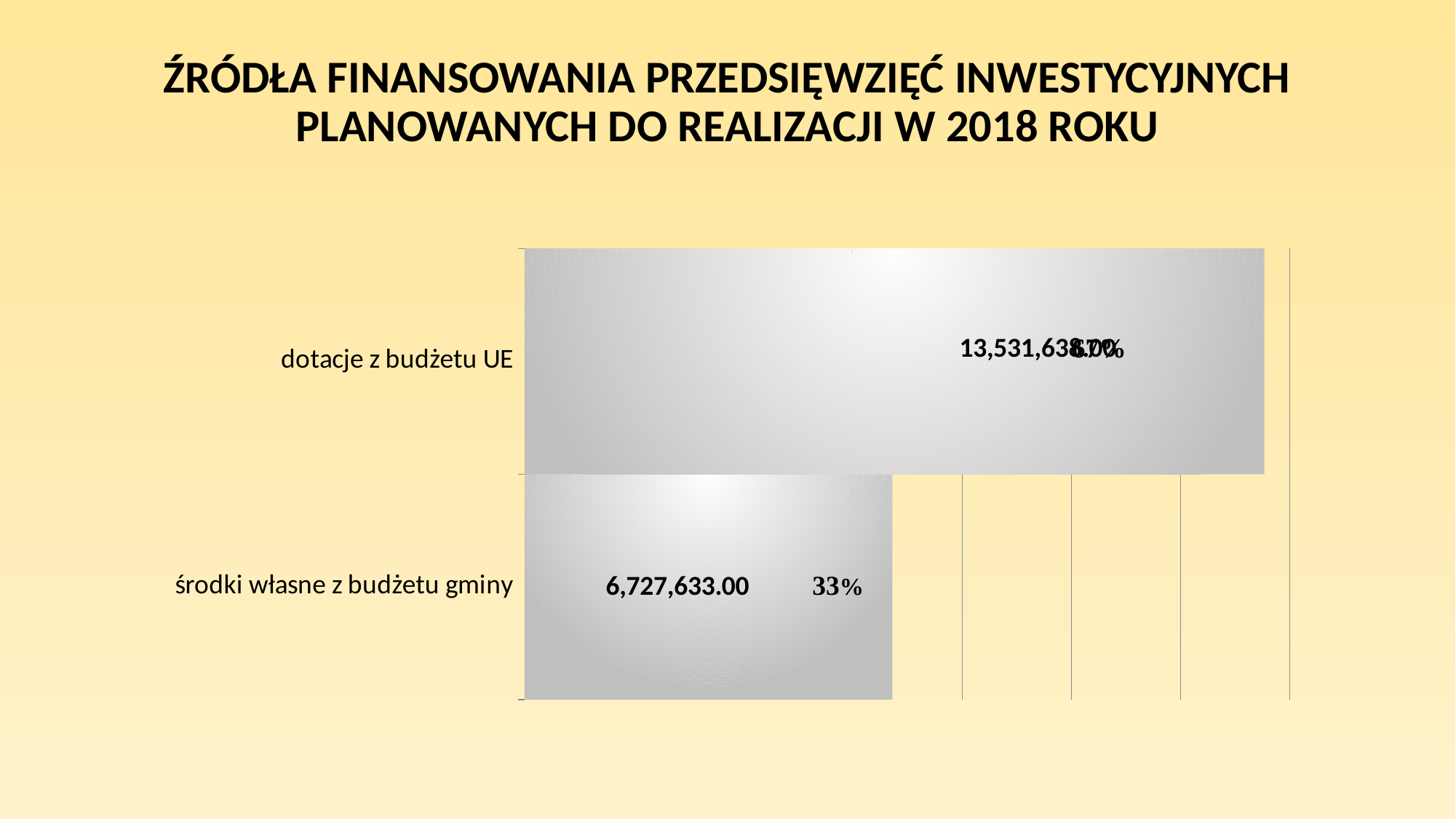
Which category has the highest value in the chart? dotacje z budżetu UE What is the title of the slide containing the chart? ŹRÓDŁA FINANSOWANIA PRZEDSIĘWZIĘĆ INWESTYCYJNYCH PLANOWANYCH DO REALIZACJI W 2018 ROKU What kind of chart is shown on the slide? bar chart Are the bars in the chart horizontal or vertical? horizontal How many categories are plotted in the chart? 2 What percentage share is shown for środki własne z budżetu gminy? 33% Which is larger: the value for dotacje z budżetu UE or the value for środki własne z budżetu gminy? dotacje z budżetu UE Which category has the lowest value in the chart? środki własne z budżetu gminy What is the value shown for środki własne z budżetu gminy? 6,727,633.00